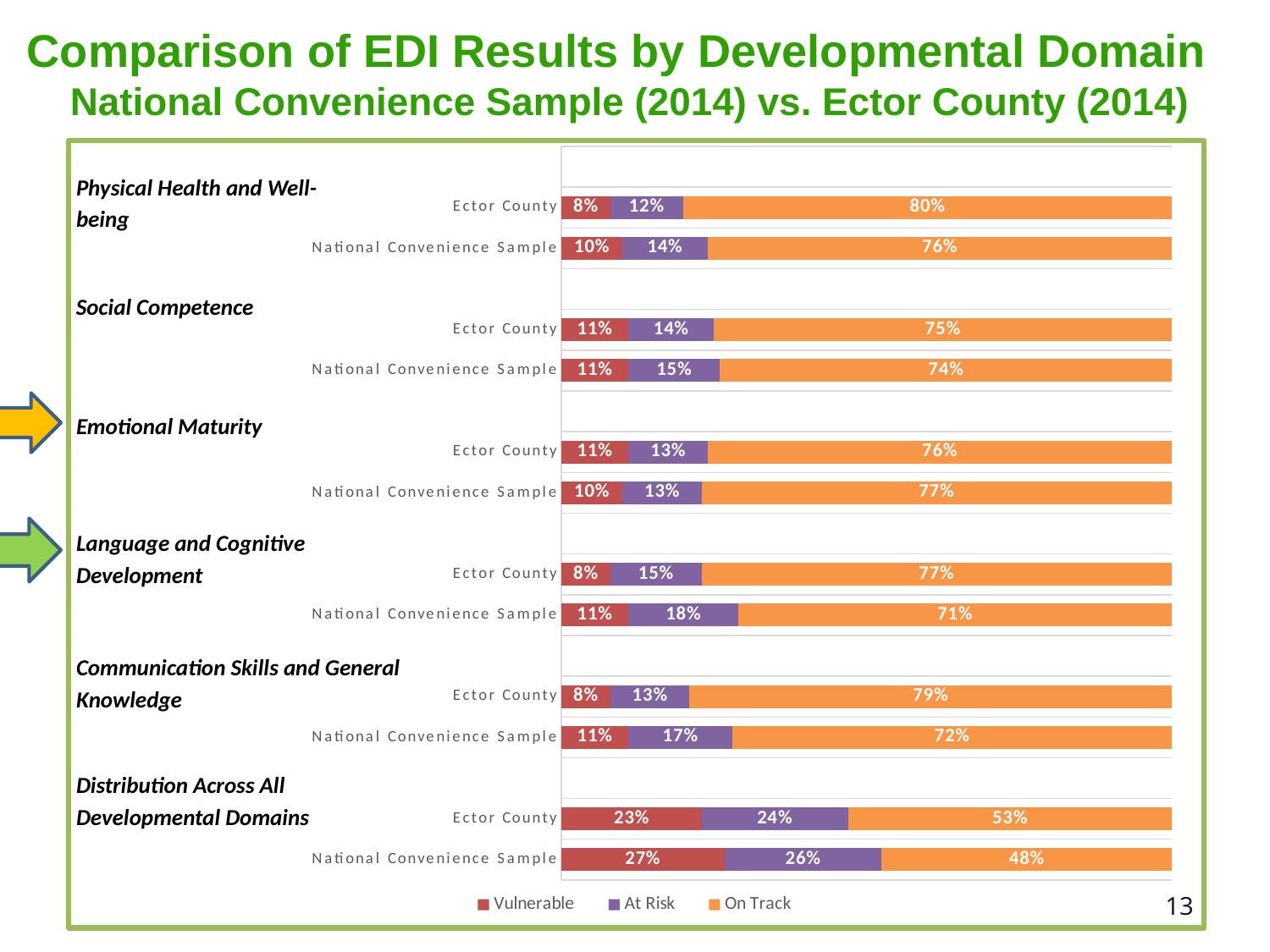
What is the On Track percentage for Ector County in Physical Health and Well-being? 80% Which bar has the lowest On Track percentage? National Convenience Sample, Distribution Across All Developmental Domains What is the difference between the Vulnerable percentages for the National Convenience Sample and Ector County in Distribution Across All Developmental Domains? 4% What is the difference between the On Track percentages for Ector County and the National Convenience Sample in Language and Cognitive Development? 6% What is the Vulnerable percentage for the National Convenience Sample in Language and Cognitive Development? 11% What kind of chart is shown on the slide? stacked bar chart In Communication Skills and General Knowledge, which has the larger At Risk percentage, Ector County or the National Convenience Sample? National Convenience Sample Which bar has the highest On Track percentage? Ector County, Physical Health and Well-being How many series does the legend list? 3 How many bars are plotted in the chart? 12 What are the three series listed in the legend? Vulnerable, At Risk, On Track What is the At Risk percentage for Ector County in Distribution Across All Developmental Domains? 24%